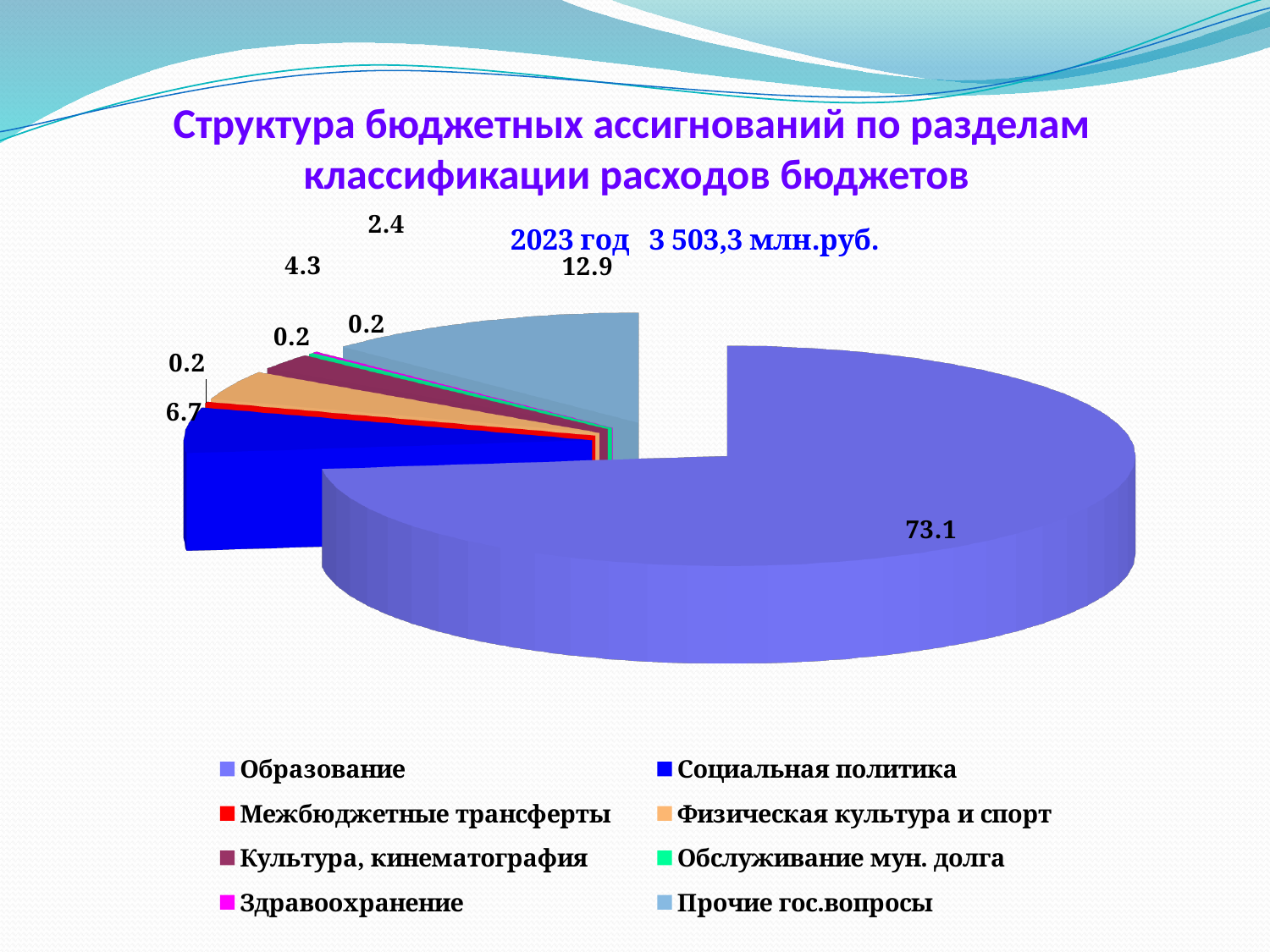
Which year does the chart refer to? 2023 What is the difference between the values for Образование and Прочие гос.вопросы? 60.2 How many categories does the legend list? 8 What total budget amount is stated above the chart for 2023? 3 503,3 млн.руб. What is the value shown for Физическая культура и спорт? 4.3 What is the value shown for Прочие гос.вопросы? 12.9 What kind of chart is shown on the slide? pie chart Which is larger, the share for Прочие гос.вопросы or for Социальная политика? Прочие гос.вопросы What is the value shown for Образование? 73.1 Which category has the largest share of the pie? Образование What is the value shown for Социальная политика? 6.7 What is the value shown for Культура, кинематография? 2.4